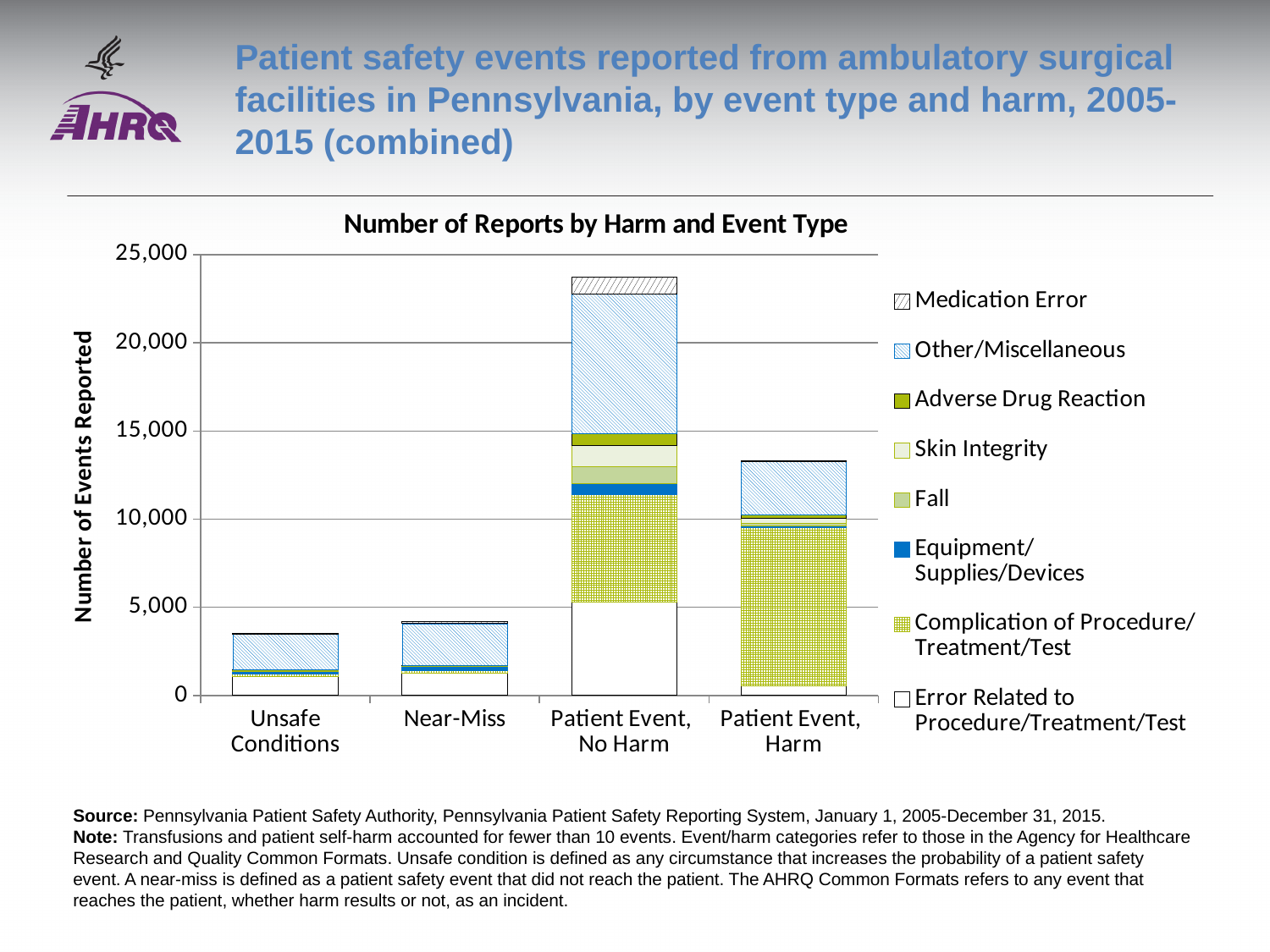
Which category has the tallest stacked bar? Patient Event, No Harm Is the total for Patient Event, Harm greater or less than 10,000? greater Is the total for Near-Miss greater or less than 5,000? less What is the label on the y axis? Number of Events Reported How many series does the legend list? 8 Is the total for Patient Event, No Harm greater or less than 20,000? greater Which has a larger total, Patient Event, No Harm or Patient Event, Harm? Patient Event, No Harm What is the title of the chart? Number of Reports by Harm and Event Type What kind of chart is shown on the slide? Stacked bar chart Which has a larger total, Patient Event, Harm or Near-Miss? Patient Event, Harm How many event categories are shown along the x axis? 4